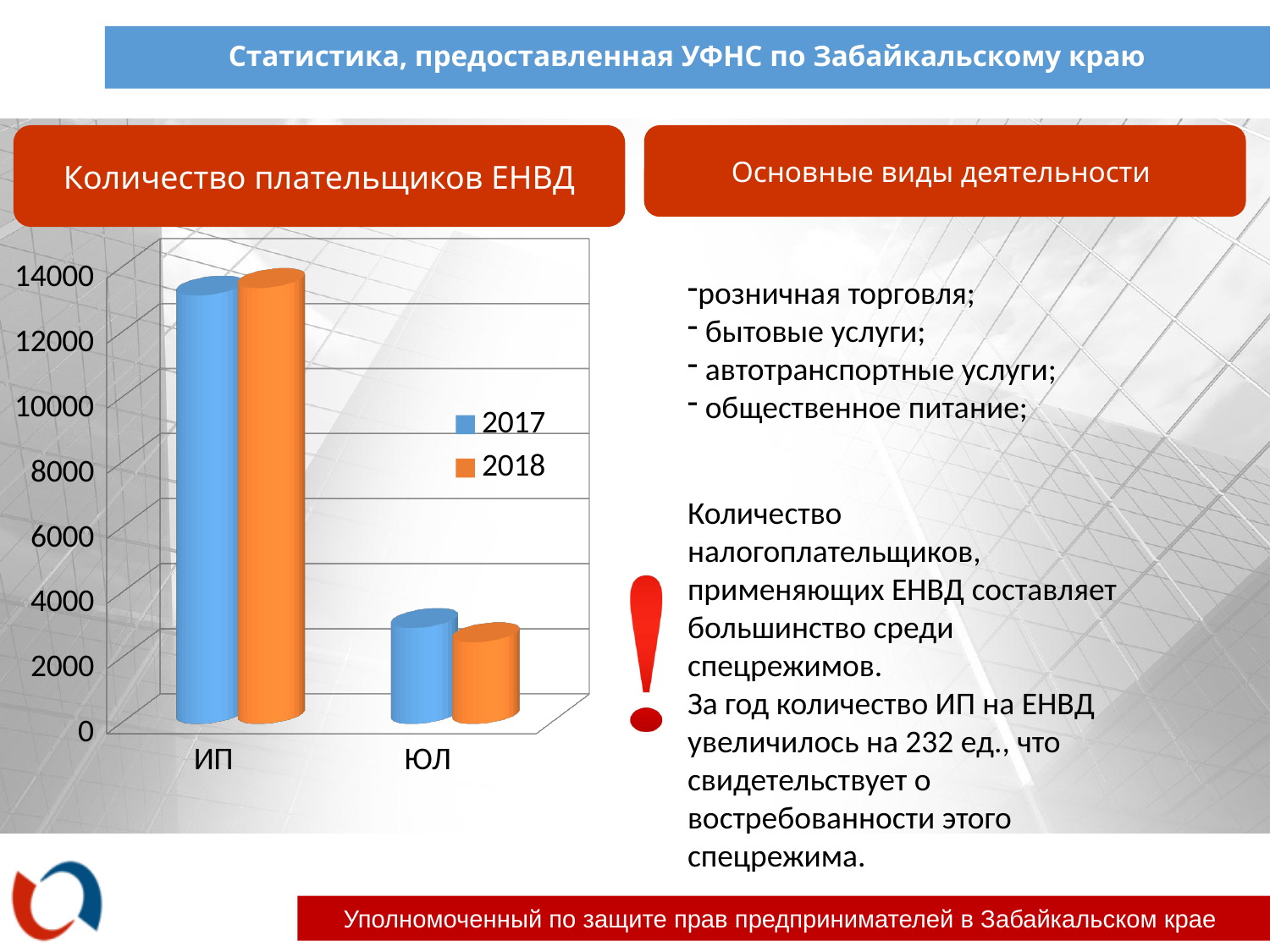
Is the 2018 value for ЮЛ greater or less than 4000? less Is the 2018 value for ИП greater or less than 12000? greater What kind of chart is shown under the heading "Количество плательщиков ЕНВД"? bar chart Which category has the lowest values in the chart? ЮЛ Which series are listed in the chart legend? 2017 and 2018 How many series does the chart legend list? 2 For 2017, which category has the larger value, ИП or ЮЛ? ИП Is the 2017 value for ЮЛ greater or less than 4000? less Do the values rise or fall moving from ИП to ЮЛ along the x axis? fall How many categories are shown on the x axis of the chart? 2 Which category has the highest values in the chart? ИП